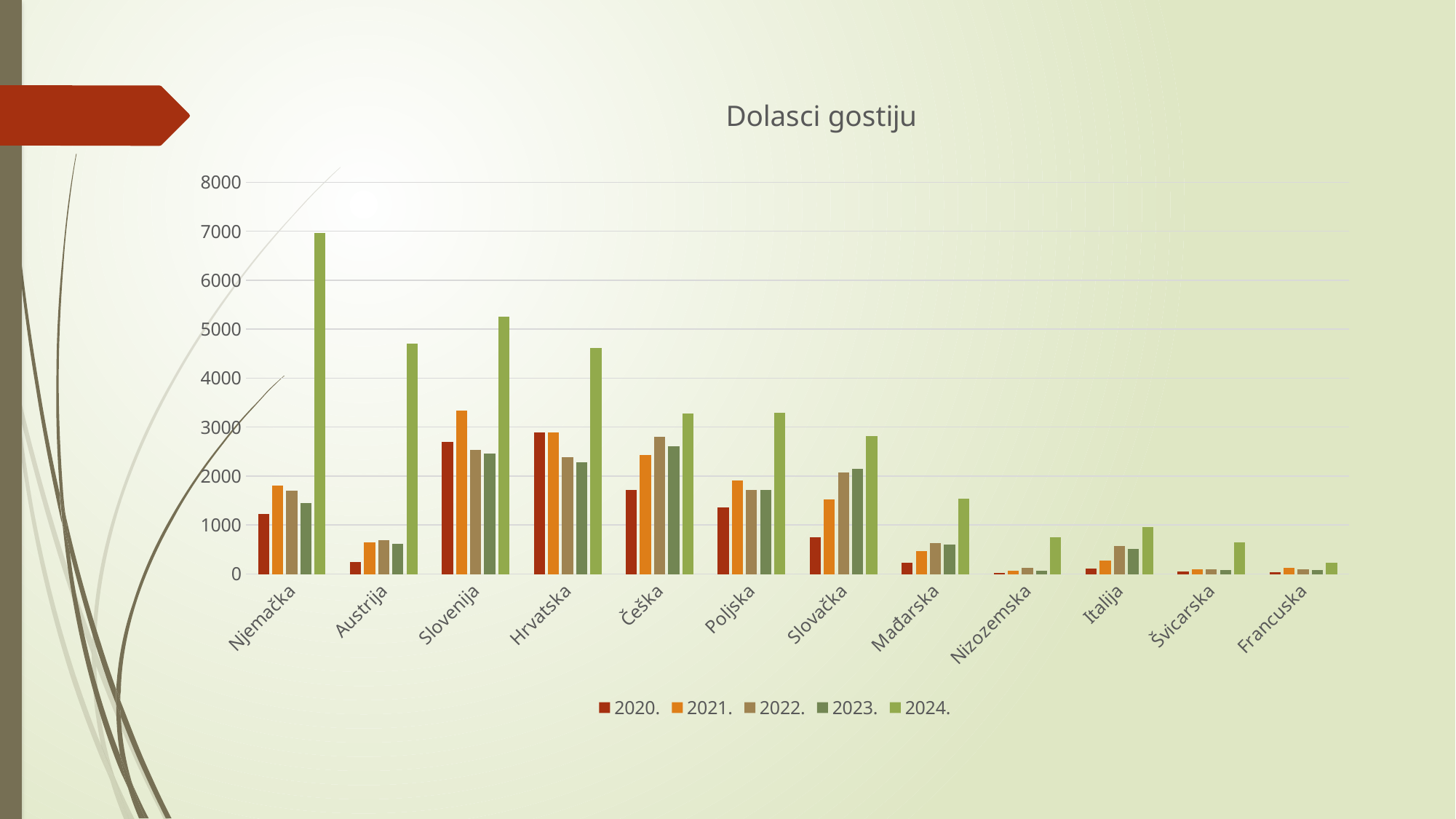
What is the title of the chart? Dolasci gostiju Is the value for Njemačka in 2024. greater or less than 6000? greater Is the value for Slovenija in 2021. greater or less than 3000? greater Is the value for Austrija in 2020. greater or less than 1000? less Which country has the highest value for 2024.? Njemačka How many countries are shown on the x axis? 12 Which is larger for 2024., Slovenija or Hrvatska? Slovenija Which is larger for 2020., Njemačka or Slovenija? Slovenija What kind of chart is shown on the slide? bar chart Which country has the lowest value for 2024.? Francuska How many series does the legend list? 5